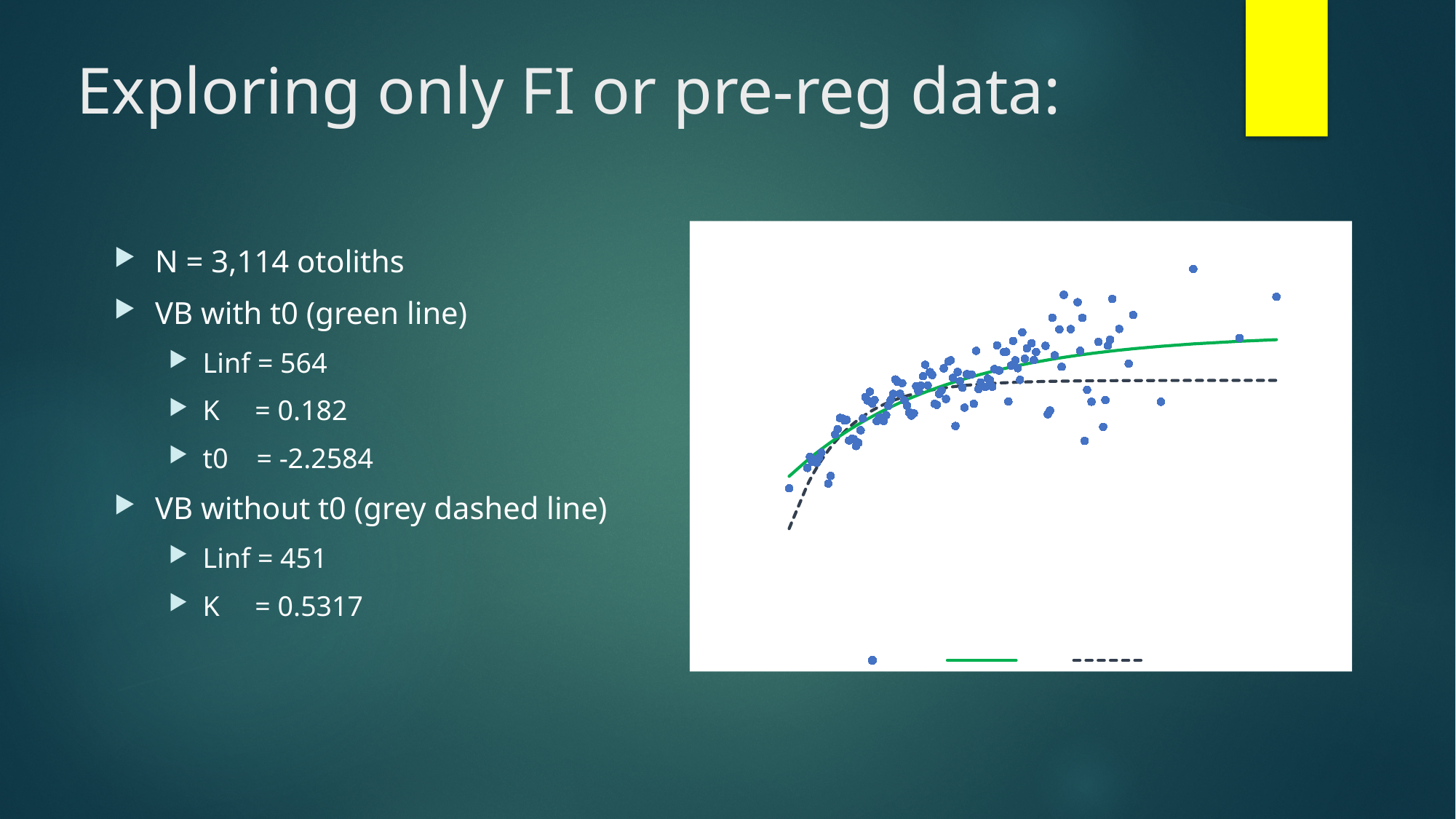
How many entries does the legend at the bottom of the chart show? 3 Does the dashed line keep rising across the whole chart or does it level off toward the right? levels off What colour are the plotted data points on the chart? blue What line style is used for the second fitted curve on the chart? dashed Do the plotted points generally rise or fall from left to right along the x axis? rise What colour is the solid fitted line on the chart? green What kind of chart is shown on the slide? scatter chart At the right-hand end of the chart, which fitted line is higher, the green solid line or the dashed line? green solid line